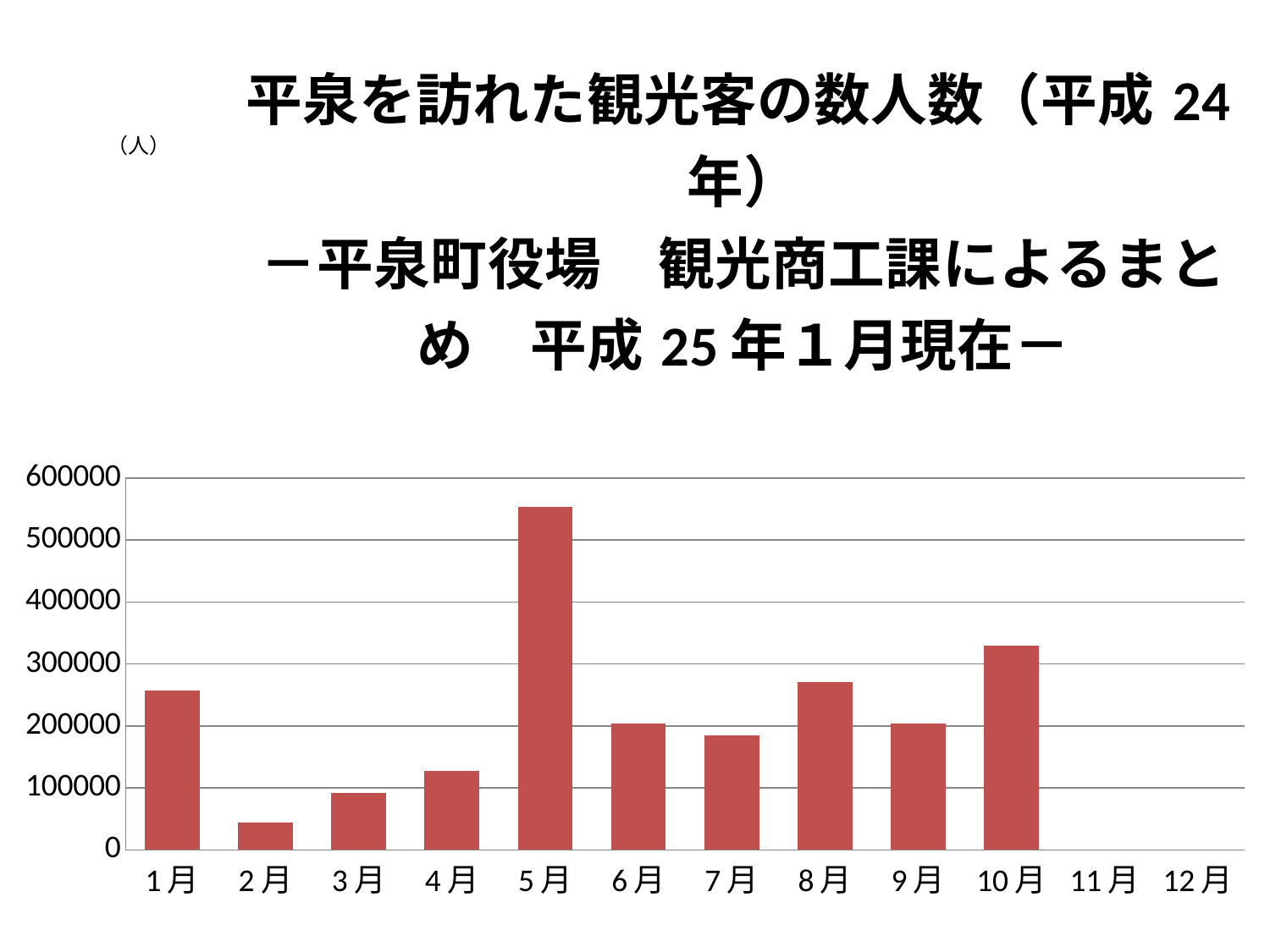
Is the value for 2月 greater or less than 100000? less How many months are listed on the x axis? 12 Is the value for 7月 greater or less than 200000? less What kind of chart is shown on the slide? bar chart Do the values rise or fall from 2月 to 5月? rise What unit is shown at the top left of the chart's vertical axis? （人） Which is larger, the value for 10月 or the value for 8月? 10月 Which is larger, the value for 3月 or the value for 4月? 4月 Among the months with a visible bar, which month has the lowest number of visitors? 2月 Is the value for 5月 greater or less than 500000? greater Which month has the highest number of visitors? 5月